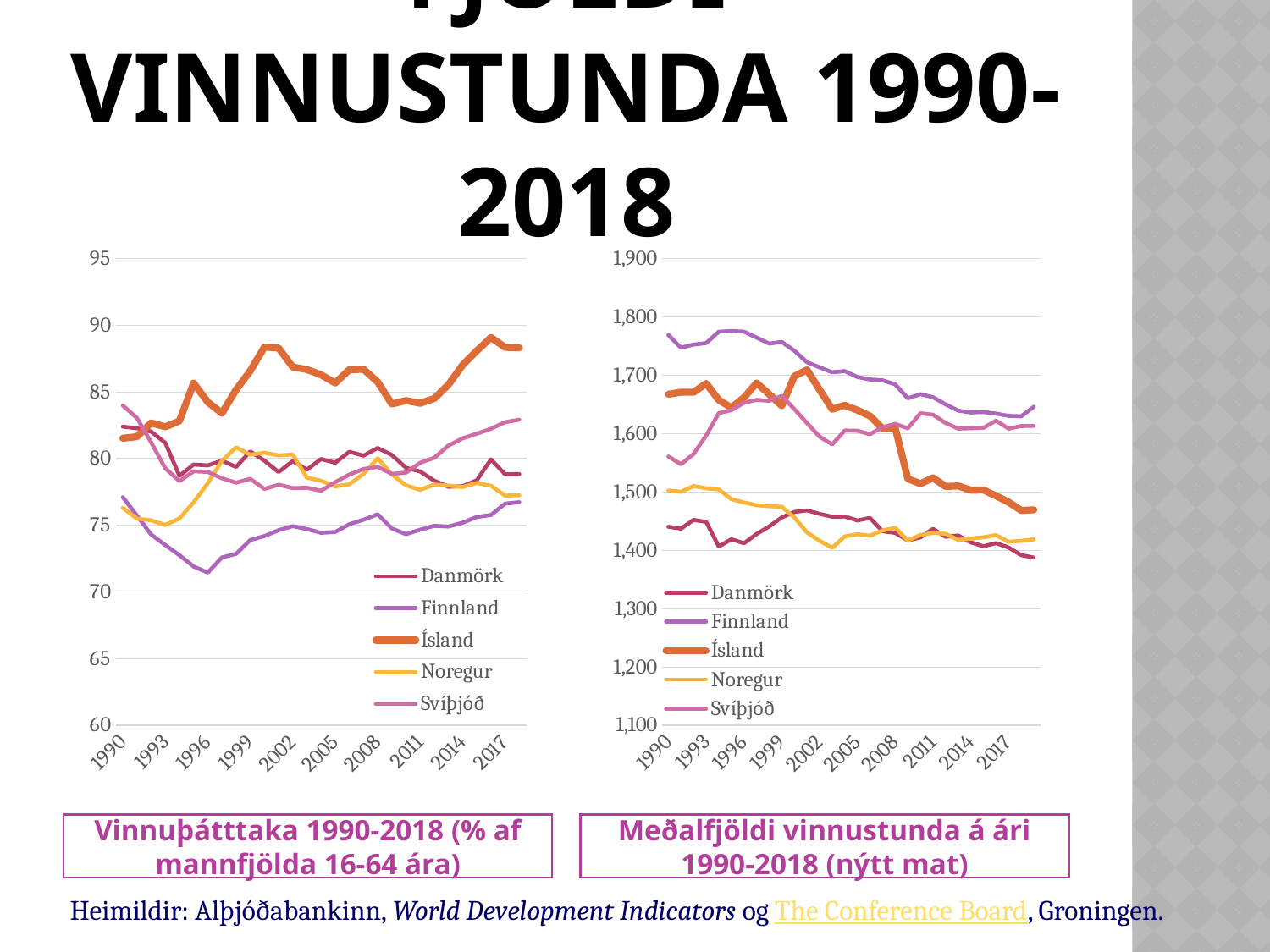
What kind of chart is the left chart, 'Vinnuþátttaka 1990-2018 (% af mannfjölda 16-64 ára)'? Line chart In the left chart, 'Vinnuþátttaka 1990-2018', does the Ísland line overall rise or fall from 1990 to 2018? Rise How many series does the legend of the right chart, 'Meðalfjöldi vinnustunda á ári 1990-2018 (nýtt mat)', list? 5 In the left chart, 'Vinnuþátttaka 1990-2018', which country has the highest value in 2017? Ísland In the right chart, 'Meðalfjöldi vinnustunda á ári 1990-2018', does the Ísland line overall rise or fall from 1990 to 2018? Fall In the left chart, 'Vinnuþátttaka 1990-2018', is the value for Ísland in 2017 greater or less than 85? greater In the right chart, 'Meðalfjöldi vinnustunda á ári 1990-2018', which country has the lowest value in 2017? Danmörk In the right chart, 'Meðalfjöldi vinnustunda á ári 1990-2018', which is larger in 1990, the value for Finnland or the value for Noregur? Finnland In the left chart, 'Vinnuþátttaka 1990-2018', which country has the lowest value in 1996? Finnland In the left chart, 'Vinnuþátttaka 1990-2018', is the value for Finnland in 1996 greater or less than 75? less In the right chart, 'Meðalfjöldi vinnustunda á ári 1990-2018', is the value for Ísland in 2017 greater or less than 1,500? less In the right chart, 'Meðalfjöldi vinnustunda á ári 1990-2018', which country has the highest value in 1990? Finnland